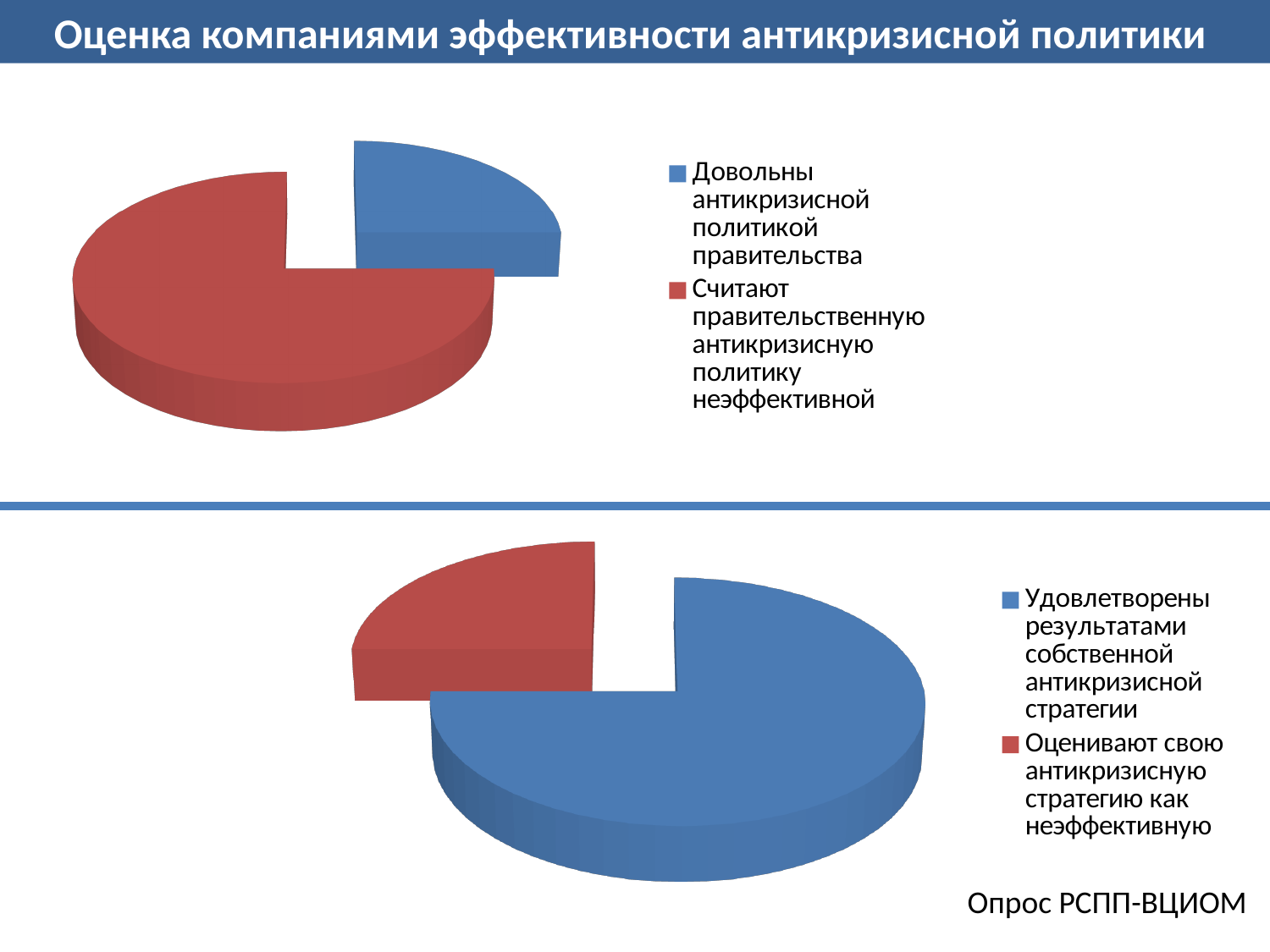
What kind of chart is the bottom chart on the slide? Pie chart How many slices does the top pie chart have? 2 How many slices does the bottom pie chart have? 2 In the bottom chart, what colour is the slice for 'Оценивают свою антикризисную стратегию как неэффективную'? Red In the bottom chart, which category has the largest slice? Удовлетворены результатами собственной антикризисной стратегии In the top chart, which category has the largest slice? Считают правительственную антикризисную политику неэффективной In the top chart, which category has the smallest slice? Довольны антикризисной политикой правительства What kind of chart is the top chart on the slide? Pie chart In the bottom chart, which slice is larger: 'Удовлетворены результатами собственной антикризисной стратегии' or 'Оценивают свою антикризисную стратегию как неэффективную'? Удовлетворены результатами собственной антикризисной стратегии In the top chart, which slice is larger: 'Довольны антикризисной политикой правительства' or 'Считают правительственную антикризисную политику неэффективной'? Считают правительственную антикризисную политику неэффективной In the bottom chart, which category has the smallest slice? Оценивают свою антикризисную стратегию как неэффективную What is the title shown at the top of the slide? Оценка компаниями эффективности антикризисной политики